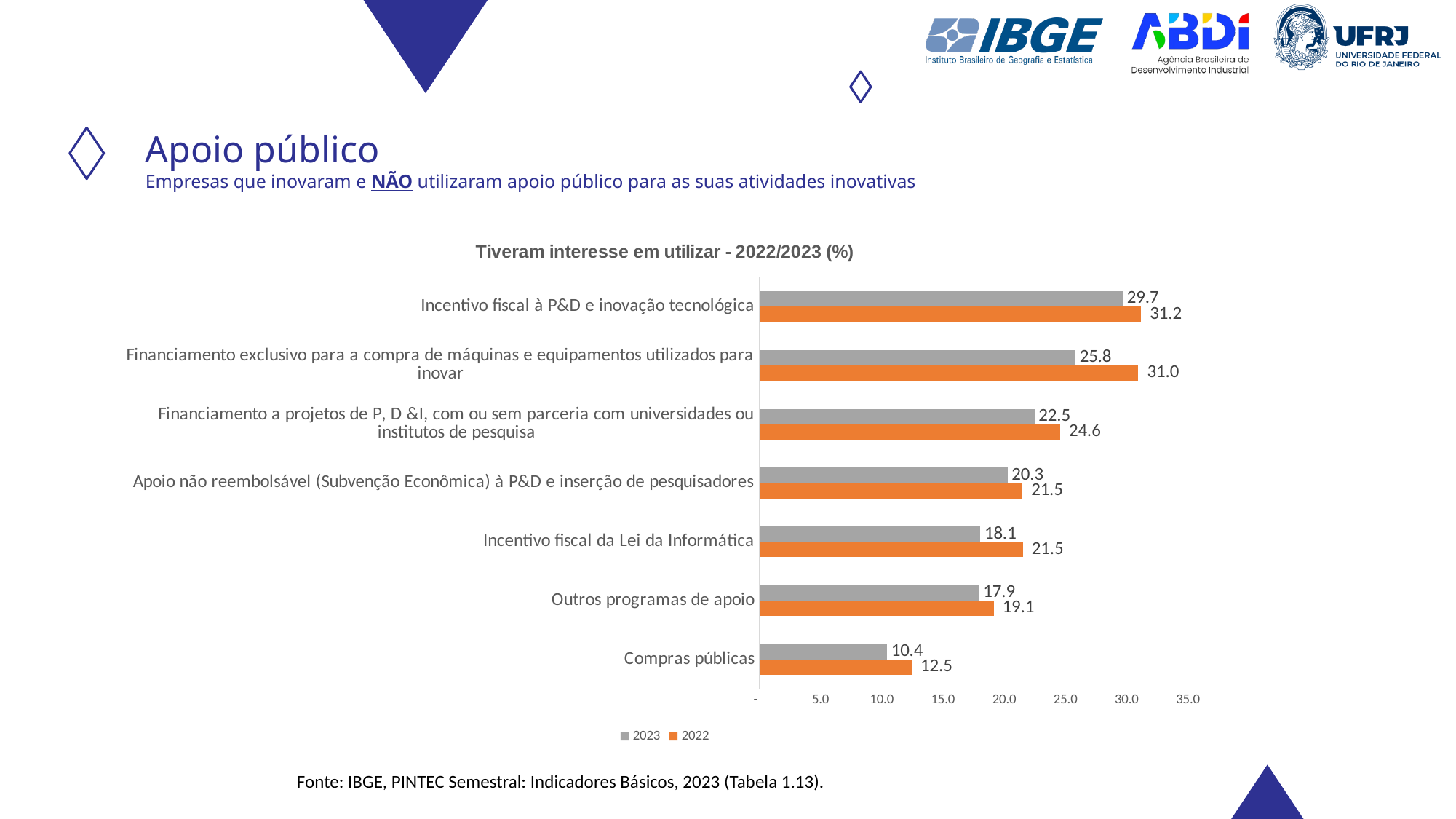
What is the 2023 value for "Incentivo fiscal à P&D e inovação tecnológica"? 29.7 Which category has the lowest 2023 value? Compras públicas How many categories are shown on the chart? 7 Which colour represents the 2022 series? Orange Which category has the highest 2022 value? Incentivo fiscal à P&D e inovação tecnológica What is the 2022 value for "Incentivo fiscal da Lei da Informática"? 21.5 Which is larger for "Outros programas de apoio": the 2022 value or the 2023 value? 2022 How many series does the legend list? 2 What is the difference between the 2022 and 2023 values for "Financiamento exclusivo para a compra de máquinas e equipamentos utilizados para inovar"? 5.2 What kind of chart is shown on the slide? Bar chart What is the 2022 value for "Compras públicas"? 12.5 What is the title of the chart? Tiveram interesse em utilizar - 2022/2023 (%)